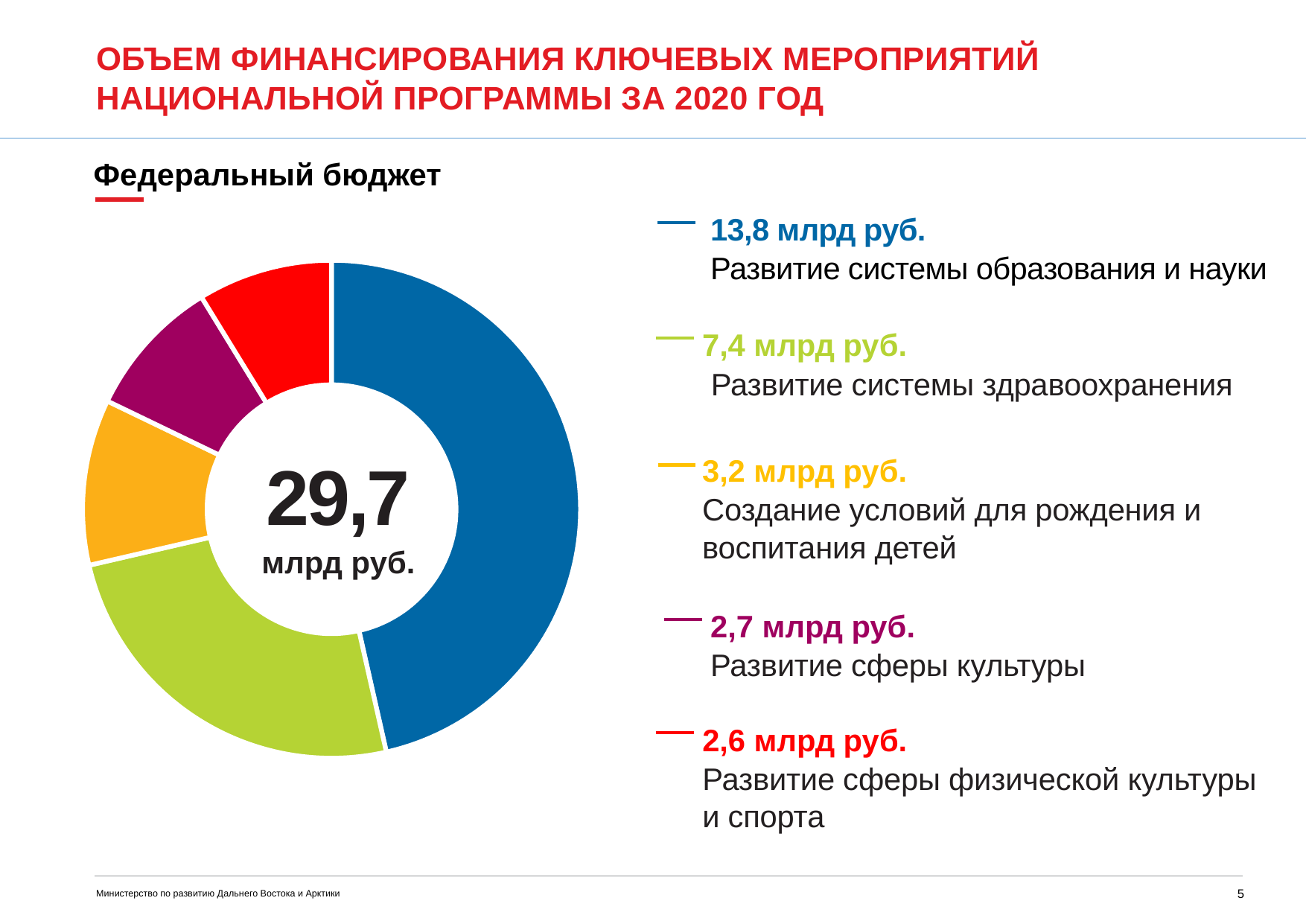
What is the funding amount for "Развитие системы здравоохранения"? 7,4 млрд руб. What is the funding amount for "Развитие системы образования и науки"? 13,8 млрд руб. What is the funding amount for "Развитие сферы физической культуры и спорта"? 2,6 млрд руб. How many segments does the donut chart have? 5 Which category receives the smallest funding amount? Развитие сферы физической культуры и спорта What colour is the segment representing "Развитие сферы культуры"? Purple (magenta) What is the total value shown in the centre of the donut chart? 29,7 млрд руб. What is the difference between the funding for "Развитие системы образования и науки" and "Развитие системы здравоохранения"? 6,4 млрд руб. What is the funding amount for "Создание условий для рождения и воспитания детей"? 3,2 млрд руб. Which category receives the largest share of the federal budget funding? Развитие системы образования и науки Which is larger: the funding for "Развитие системы здравоохранения" or for "Развитие сферы культуры"? Развитие системы здравоохранения What kind of chart is shown on the slide? Donut (pie) chart